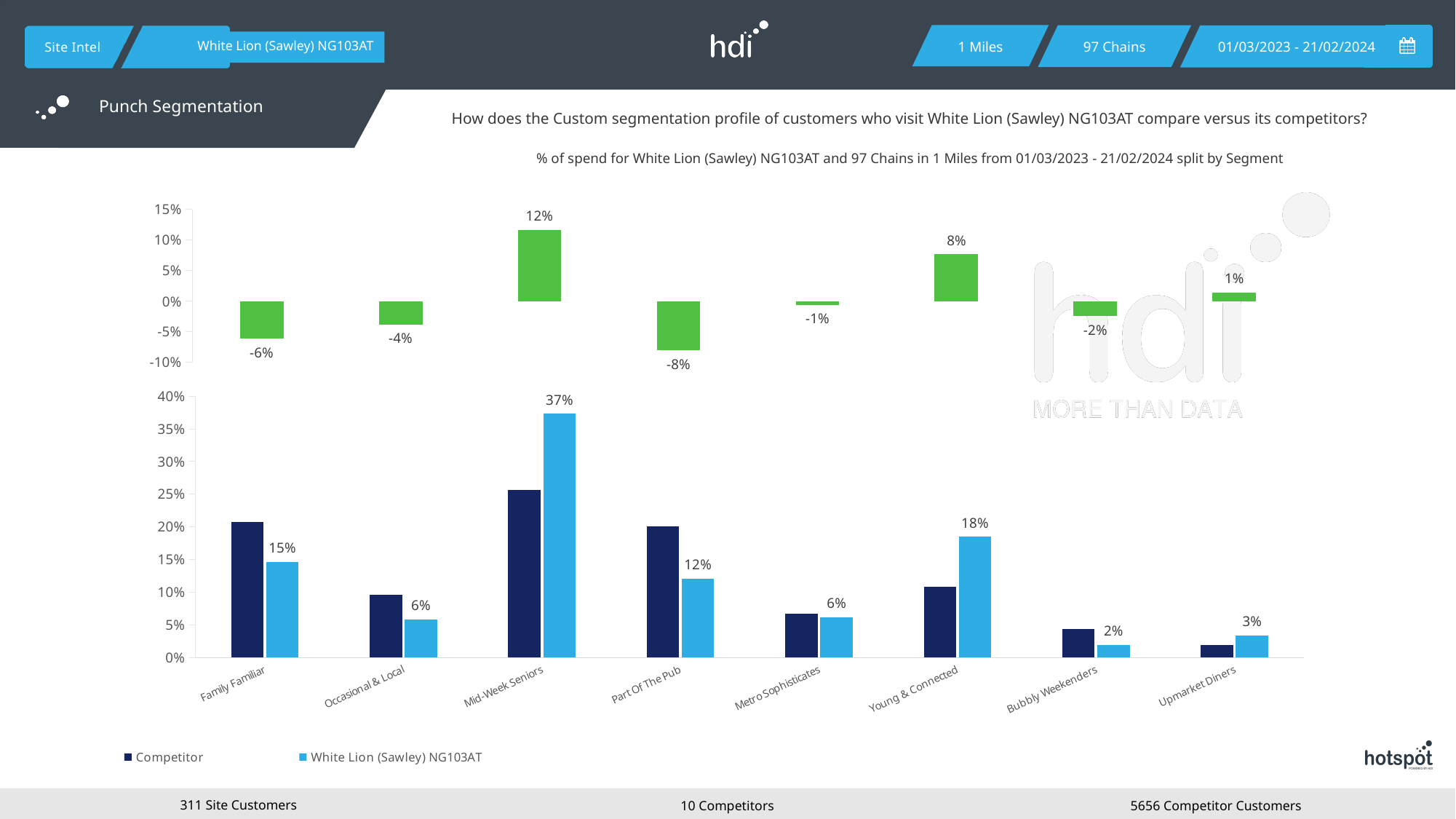
In the top chart, what is the value shown for Part Of The Pub? -8% In the bottom chart, for Family Familiar, which series has the larger value: Competitor or White Lion (Sawley) NG103AT? Competitor In the top chart, which segment has the lowest value? Part Of The Pub How many segments are shown on the x axis of the bottom chart? 8 In the bottom chart, what is the value for White Lion (Sawley) NG103AT in the Young & Connected segment? 18% In the bottom chart, is the Competitor value for Part Of The Pub greater or less than 15%? greater In the bottom chart, what is the difference between the White Lion (Sawley) NG103AT values for Mid-Week Seniors and Part Of The Pub? 25% In the bottom chart, which segment has the lowest value for White Lion (Sawley) NG103AT? Bubbly Weekenders In the top chart, which segment has the highest value? Mid-Week Seniors What kind of chart is the bottom chart? bar chart How many series does the legend of the bottom chart list? 2 In the bottom chart, what is the value for White Lion (Sawley) NG103AT in the Mid-Week Seniors segment? 37%